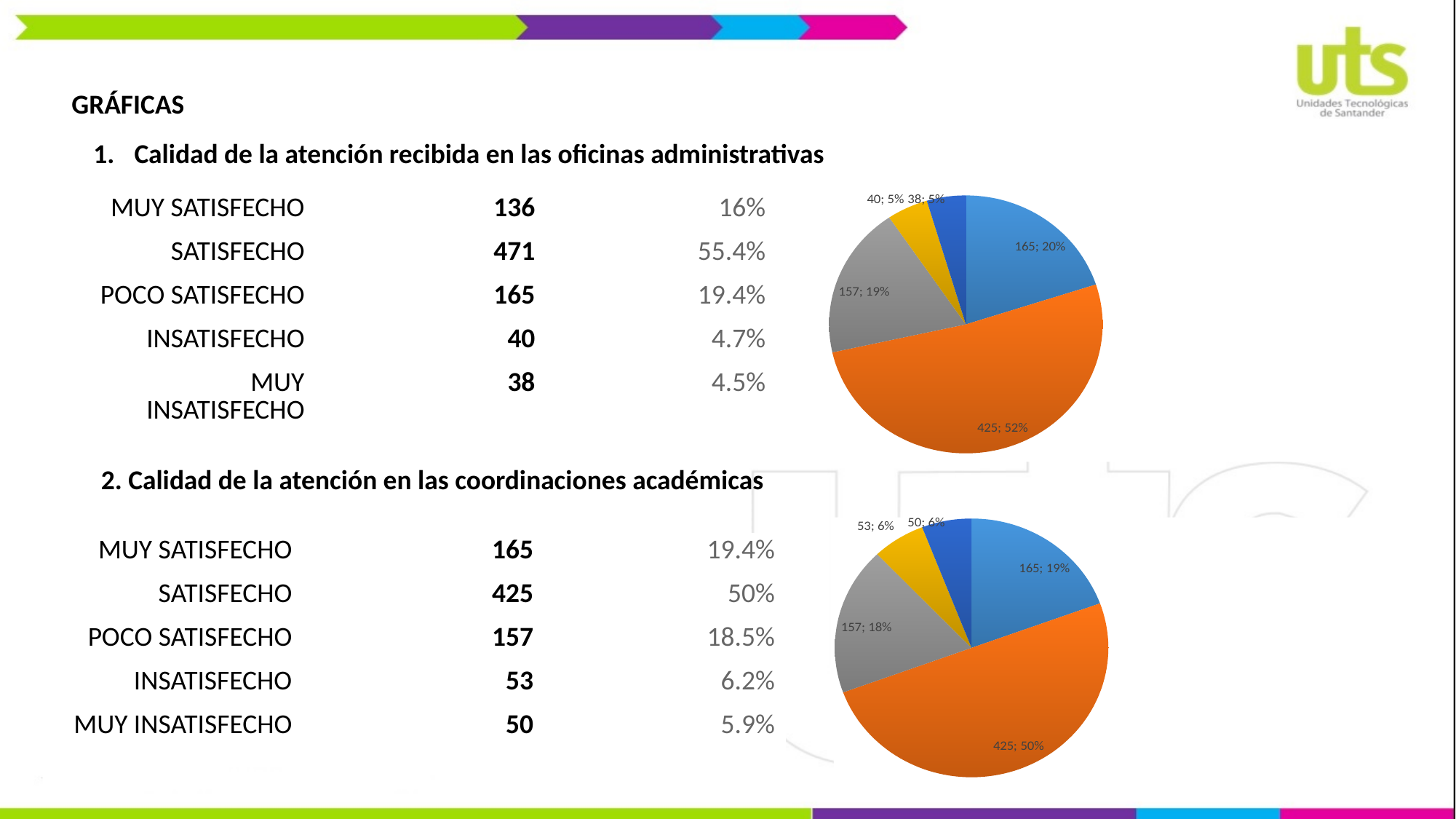
In the top pie chart, what percentage is printed on the largest slice? 52% In the bottom pie chart, which category has the smallest slice? MUY INSATISFECHO In the bottom pie chart, what colour is the largest slice? Orange In the bottom pie chart, what is the count for SATISFECHO? 425 What kind of chart is used for 'Calidad de la atención recibida en las oficinas administrativas' (top chart)? Pie chart In the top pie chart, what count is printed on the largest slice? 425 In the bottom pie chart, what share of the pie does SATISFECHO represent? 50% How many slices does the bottom pie chart ('Calidad de la atención en las coordinaciones académicas') have? 5 In the bottom pie chart, what is the difference between the counts for SATISFECHO and MUY SATISFECHO? 260 In the bottom pie chart, what is the count for POCO SATISFECHO? 157 How many slices does the top pie chart have? 5 In the top pie chart, what count is printed on the smallest slice? 38